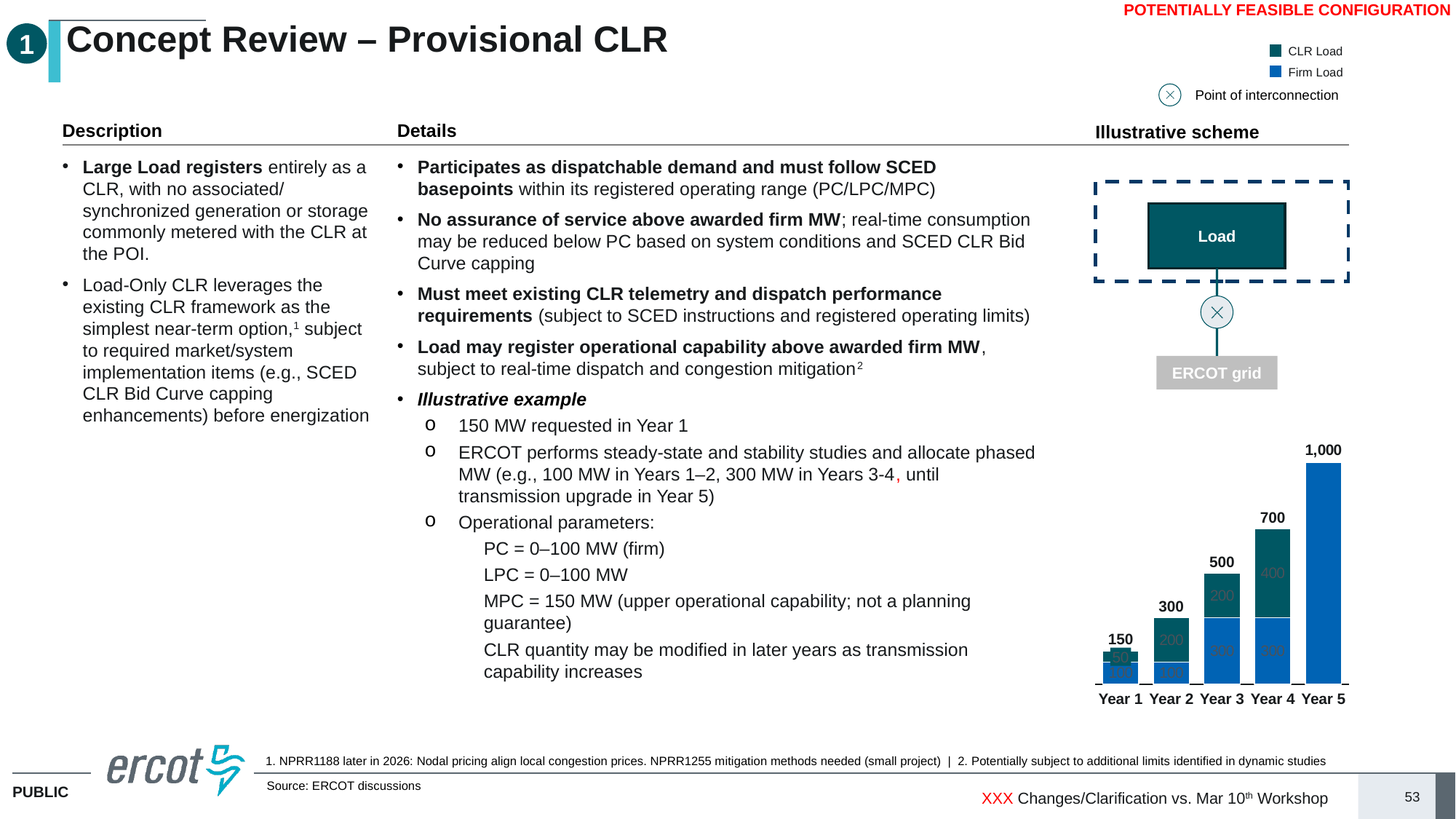
How many years (categories) are shown on the x axis of the bar chart? 5 What is the total value shown above the bar for Year 5? 1,000 Is the total for Year 3 larger or smaller than the total for Year 4? smaller What is the CLR Load value for Year 4? 400 What kind of chart is used to show the Year 1 to Year 5 values? Stacked bar chart Which year has the highest total in the bar chart? Year 5 What is the difference between the total for Year 4 and the total for Year 2? 400 Which two load series does the legend list for the bar chart? CLR Load and Firm Load What is the Firm Load value for Year 3? 300 Do the bar totals rise or fall from Year 1 to Year 5? rise Which year has the lowest total in the bar chart? Year 1 What is the total value shown above the bar for Year 3? 500